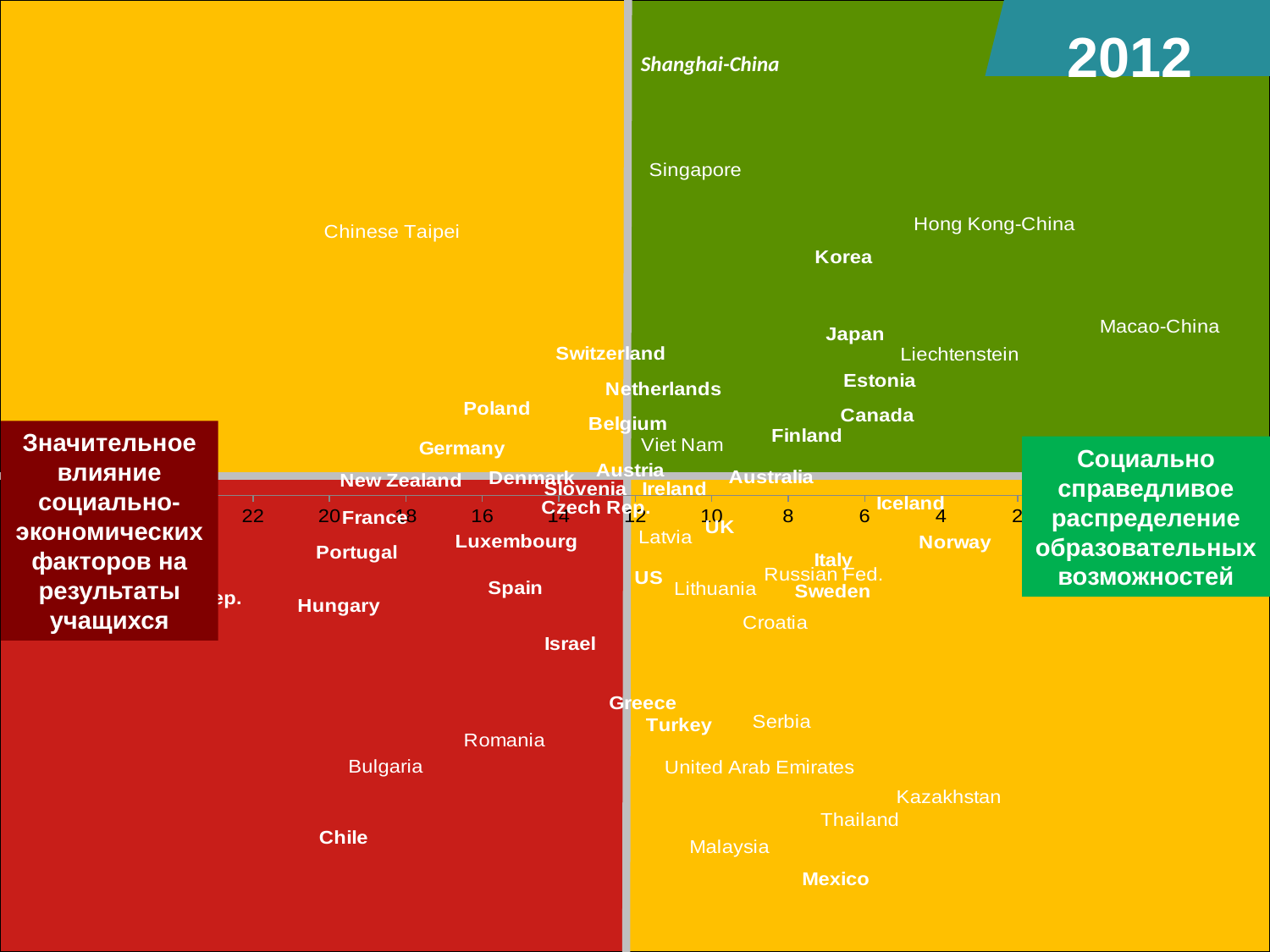
Is the x-axis value for Turkey greater or less than 10? greater Which has the larger x-axis value, Chile or Mexico? Chile Is the x-axis value for Macao-China greater or less than 4? less Which country label is positioned highest on the chart? Shanghai-China What colour is the top-right quadrant of the chart? green What year is shown in the top-right corner of the chart? 2012 Is the x-axis value for Chinese Taipei greater or less than 16? greater Which country label is positioned lowest on the chart? Mexico Which has the larger x-axis value, Chinese Taipei or Hong Kong-China? Chinese Taipei What kind of chart is shown on the slide? scatter chart